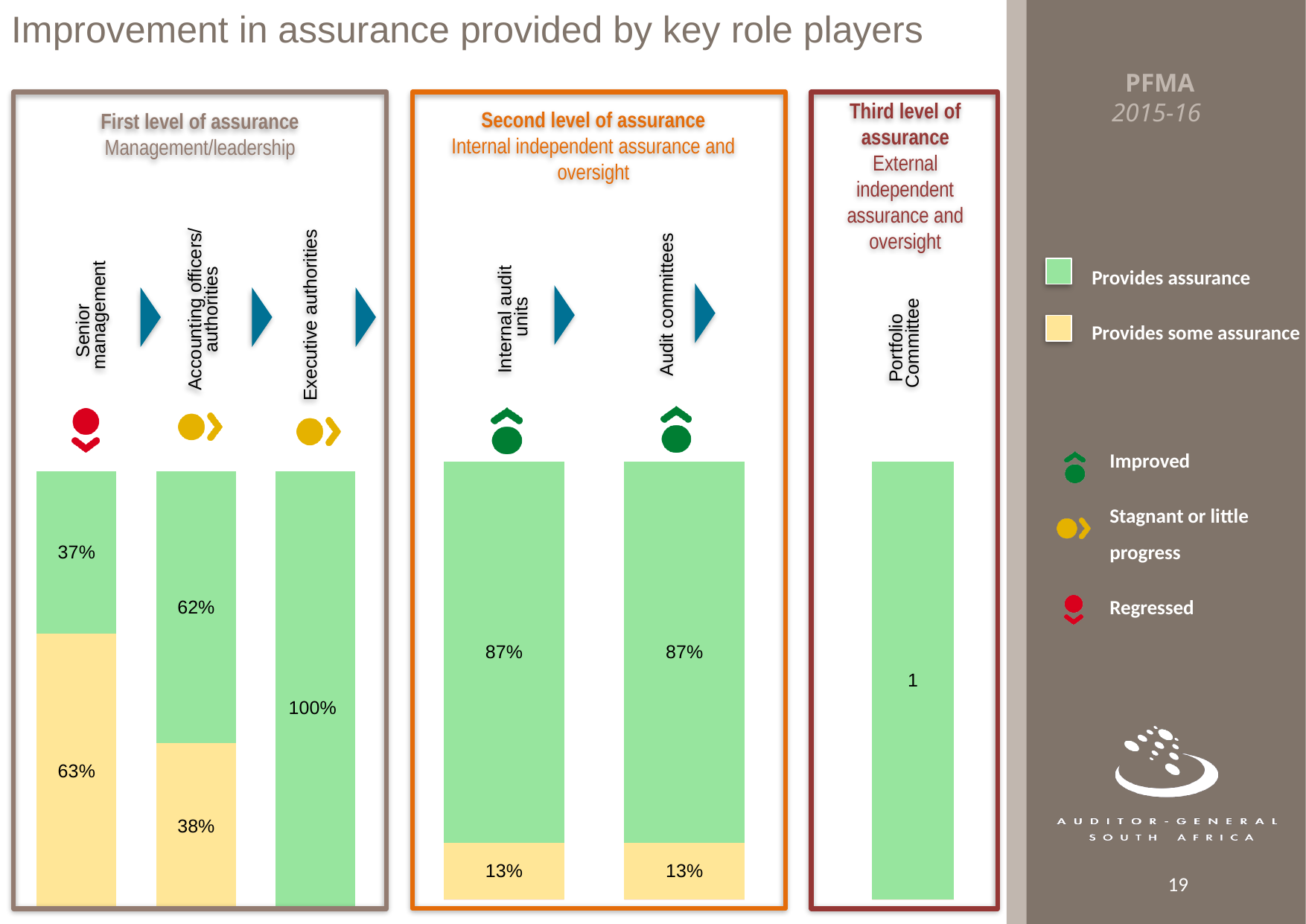
In the First level of assurance chart, which category has the lowest 'Provides assurance' share? Senior management In the First level of assurance chart, what is the 'Provides assurance' value for Executive authorities? 100% How many categories are shown in the First level of assurance chart? 3 In the First level of assurance chart, what is the 'Provides assurance' value for Accounting officers/authorities? 62% In the First level of assurance chart, what percentage of Senior management provides assurance? 37% What type of chart is used in the Second level of assurance panel? Stacked bar chart What value is printed on the Portfolio Committee bar in the Third level of assurance chart? 1 In the First level of assurance chart, what is the difference between the 'Provides assurance' values for Accounting officers/authorities and Senior management? 25% In the Second level of assurance chart, what percentage of Internal audit units provides some assurance? 13% In the First level of assurance chart, what percentage of Senior management provides some assurance? 63% In the Second level of assurance chart, what is the 'Provides assurance' value for Audit committees? 87% In the First level of assurance chart, which category has the highest 'Provides assurance' share? Executive authorities